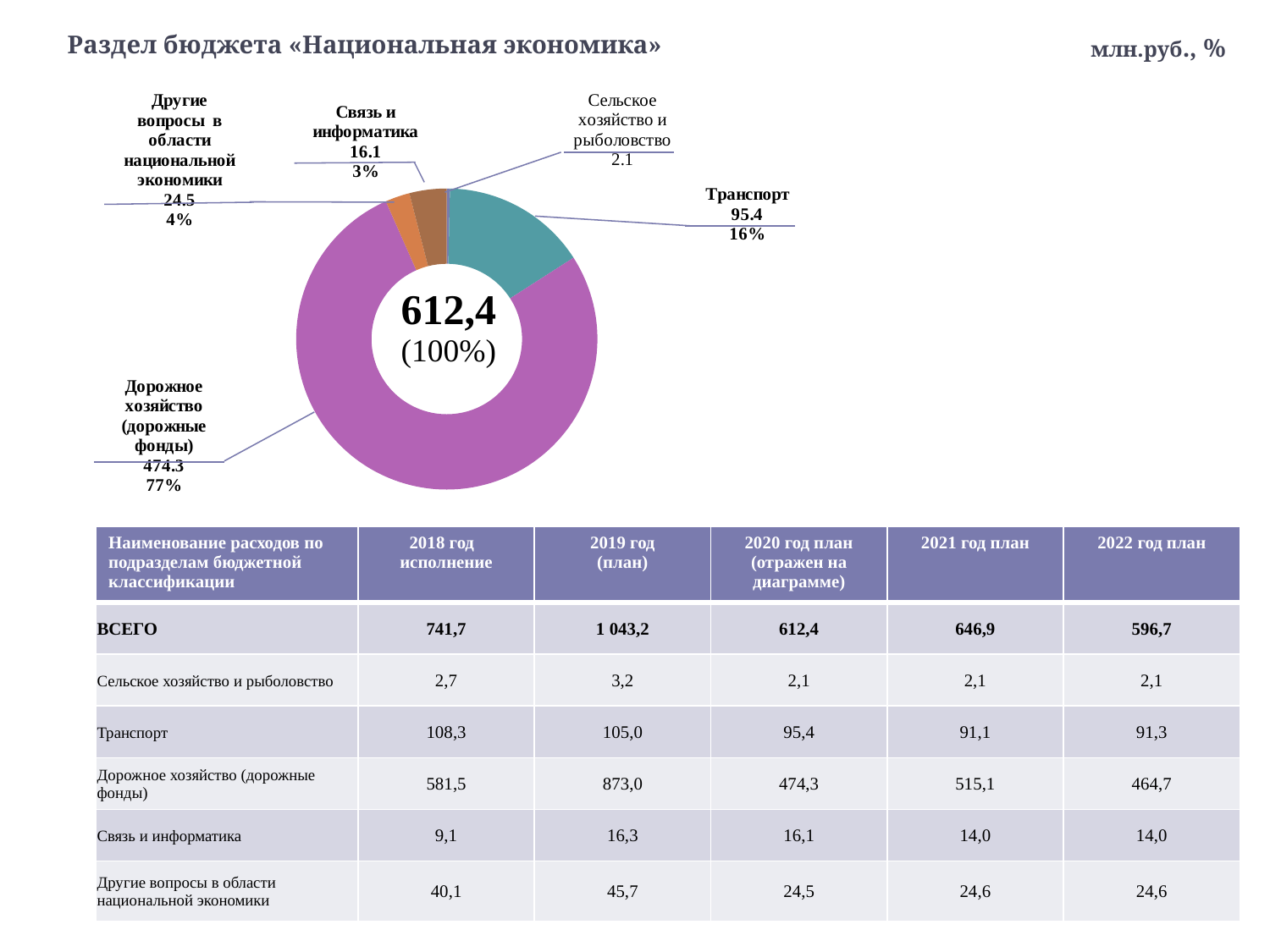
What is the value for Дорожное хозяйство (дорожные фонды) in the chart? 474.3 What is the value for Сельское хозяйство и рыболовство in the chart? 2.1 What kind of chart is shown on the slide? Pie (donut) chart What share of the chart does Транспорт represent? 16% What total value is shown in the centre of the chart? 612,4 What is the value for Связь и информатика in the chart? 16.1 Which is larger in the chart, Транспорт or Другие вопросы в области национальной экономики? Транспорт How many categories are shown in the chart? 5 Which category has the largest slice in the chart? Дорожное хозяйство (дорожные фонды) What share of the chart does Дорожное хозяйство (дорожные фонды) represent? 77% What is the value for Транспорт in the chart? 95.4 Which category has the smallest slice in the chart? Сельское хозяйство и рыболовство